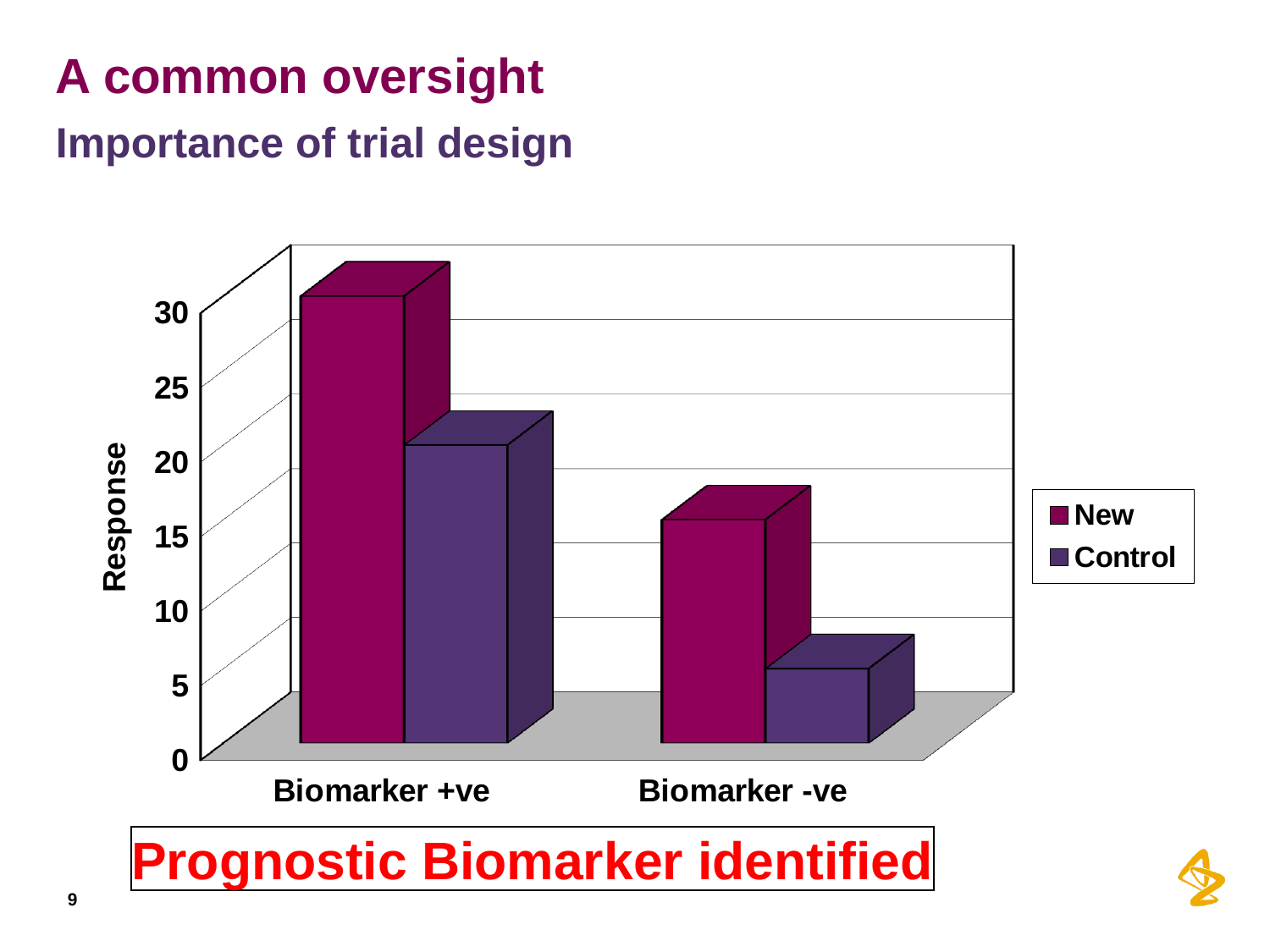
What kind of chart is shown on the slide? Bar chart Which bar is the shortest in the chart? Control, Biomarker -ve For Biomarker +ve, which is larger: New or Control? New How many categories are shown on the x axis? 2 What is the label on the vertical axis? Response Do the values for the New series rise or fall from Biomarker +ve to Biomarker -ve? fall How many series does the legend list? 2 For Biomarker -ve, which is larger: New or Control? New What are the two series named in the legend? New and Control Which bar is the tallest in the chart? New, Biomarker +ve Is the value for New in Biomarker +ve greater or less than 25? greater Is the value for Control in Biomarker -ve greater or less than 10? less